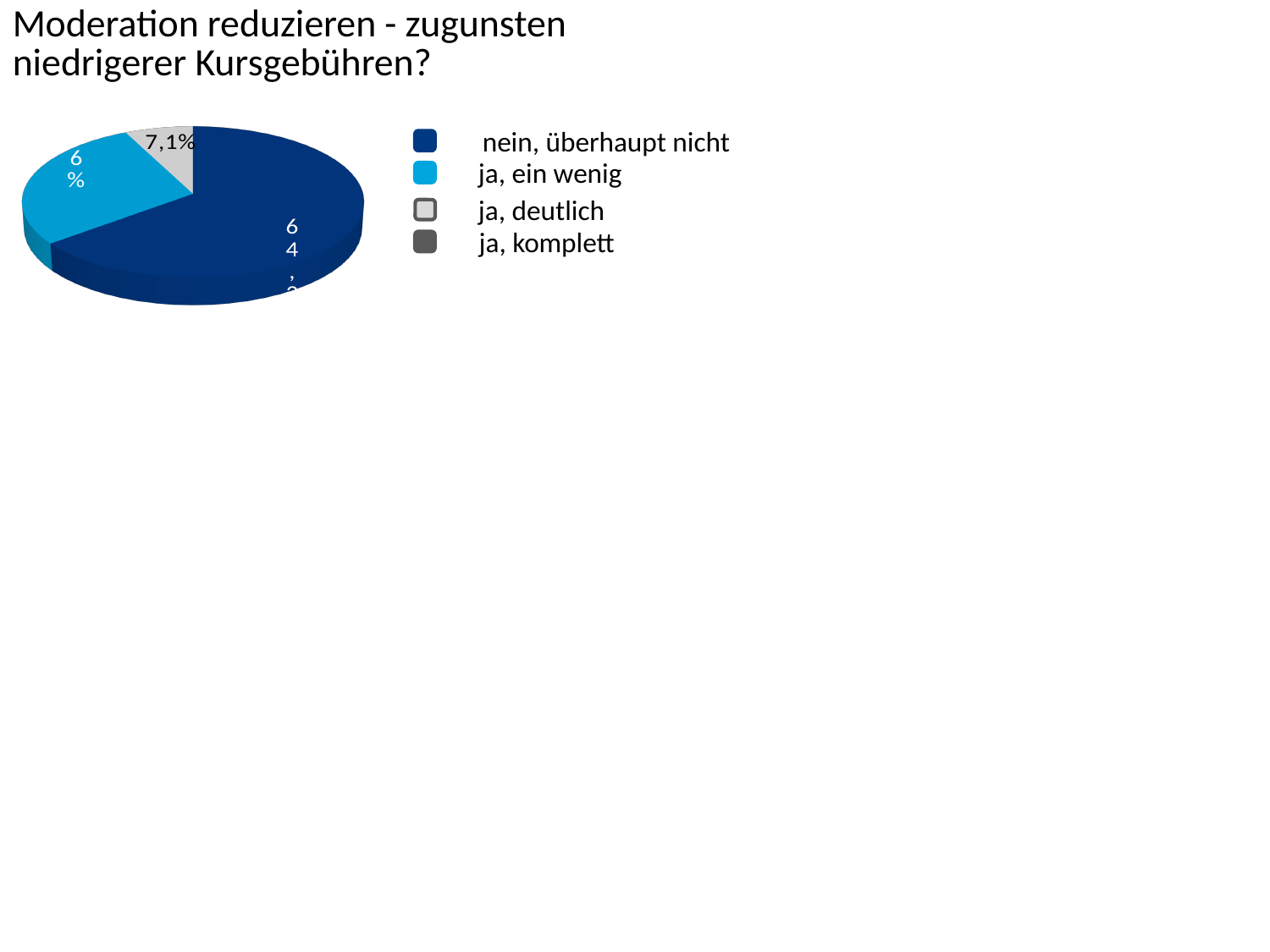
What kind of chart is shown on the slide? pie chart What is the title of the slide containing the pie chart? Moderation reduzieren - zugunsten niedrigerer Kursgebühren? What percentage is shown for the 'ja, deutlich' slice? 7,1% How many entries does the legend of the pie chart list? 4 What colour is the 'nein, überhaupt nicht' slice in the pie chart? dark blue Which category has the largest slice of the pie? nein, überhaupt nicht Which slice is larger: 'ja, ein wenig' or 'ja, deutlich'? ja, ein wenig Which slice is larger: 'nein, überhaupt nicht' or 'ja, ein wenig'? nein, überhaupt nicht